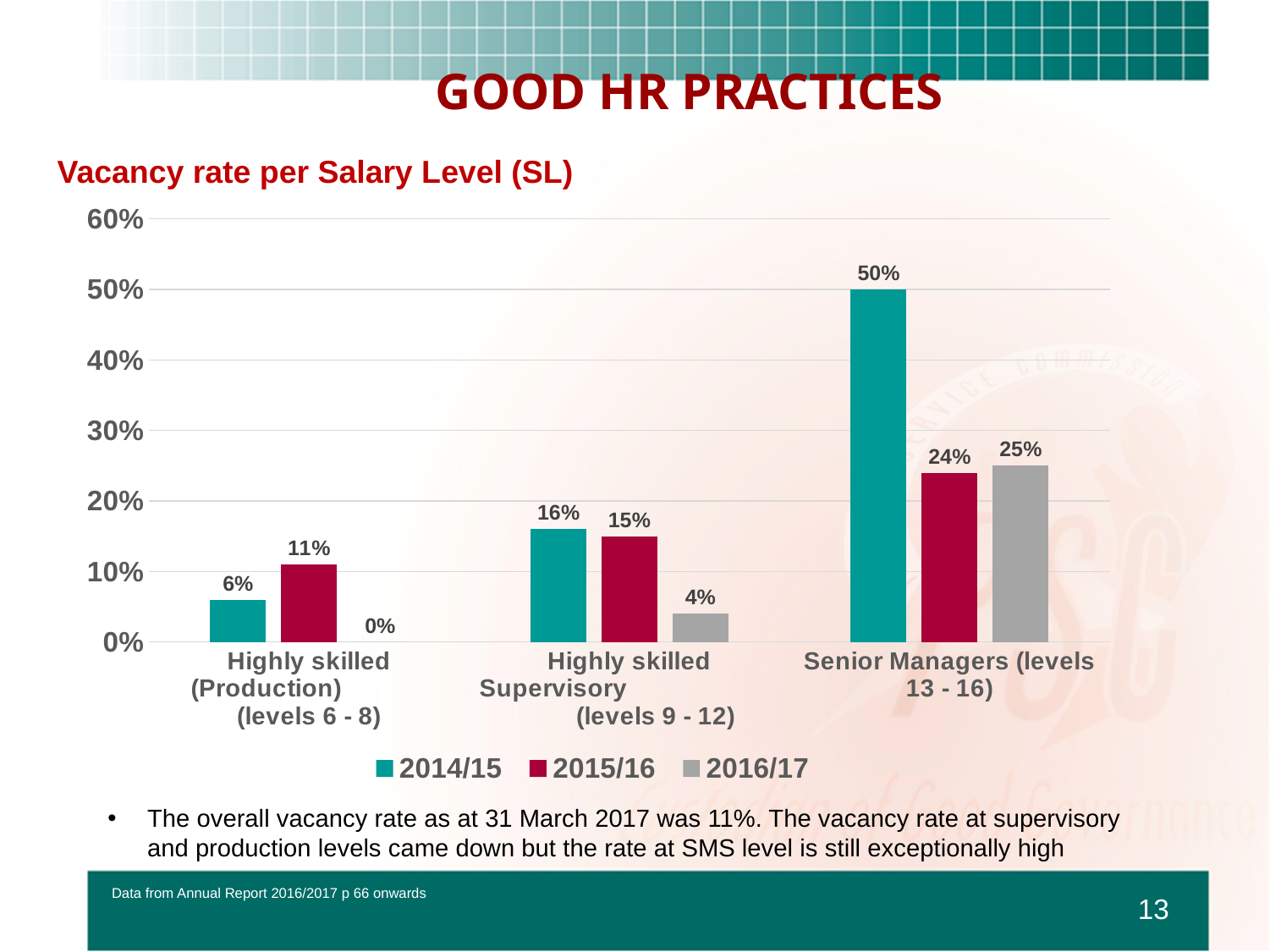
What is the difference between the 2014/15 and 2015/16 vacancy rates for Senior Managers (levels 13 - 16)? 26% What is the 2015/16 vacancy rate for Highly skilled (Production) (levels 6 - 8)? 11% What kind of chart is shown on the slide? Bar chart What is the 2016/17 vacancy rate for Highly skilled Supervisory (levels 9 - 12)? 4% Which salary level has the highest 2014/15 vacancy rate? Senior Managers (levels 13 - 16) What is the title of the chart? Vacancy rate per Salary Level (SL) How many series does the legend list? 3 Which is larger for Highly skilled Supervisory (levels 9 - 12): the 2014/15 rate or the 2015/16 rate? 2014/15 Is the 2014/15 vacancy rate for Senior Managers (levels 13 - 16) greater or less than 40%? greater How many salary level categories are shown on the x axis? 3 What is the 2014/15 vacancy rate for Senior Managers (levels 13 - 16)? 50% Which salary level has the lowest 2016/17 vacancy rate? Highly skilled (Production) (levels 6 - 8)